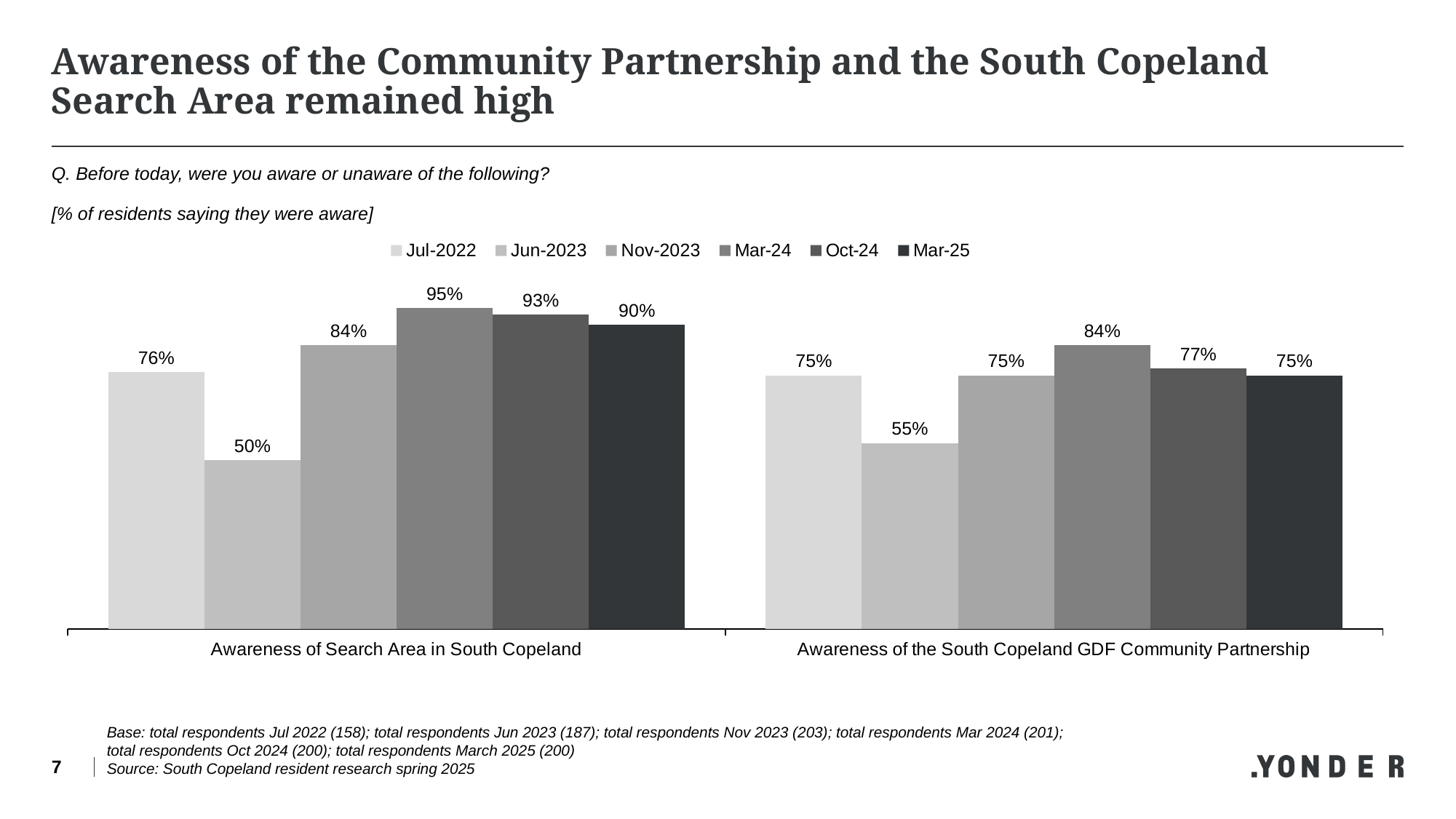
What percentage of residents were aware of the Search Area in South Copeland in Mar-24? 95% How many survey waves does the legend list? 6 Did awareness of the Search Area in South Copeland rise or fall between Mar-24 and Mar-25? Fall What kind of chart is shown on the slide? Bar chart What is the difference between awareness of the Search Area in South Copeland in Mar-24 and in Jun-2023? 45 percentage points In which survey wave was awareness of the South Copeland GDF Community Partnership highest? Mar-24 How many categories are shown on the x axis? 2 In which survey wave was awareness of the Search Area in South Copeland lowest? Jun-2023 What percentage of residents were aware of the South Copeland GDF Community Partnership in Jun-2023? 55% By how much did awareness of the South Copeland GDF Community Partnership fall from Oct-24 to Mar-25? 2 percentage points What was awareness of the South Copeland GDF Community Partnership in Mar-25? 75% Which was higher in Nov-2023: awareness of the Search Area in South Copeland or awareness of the South Copeland GDF Community Partnership? Awareness of Search Area in South Copeland